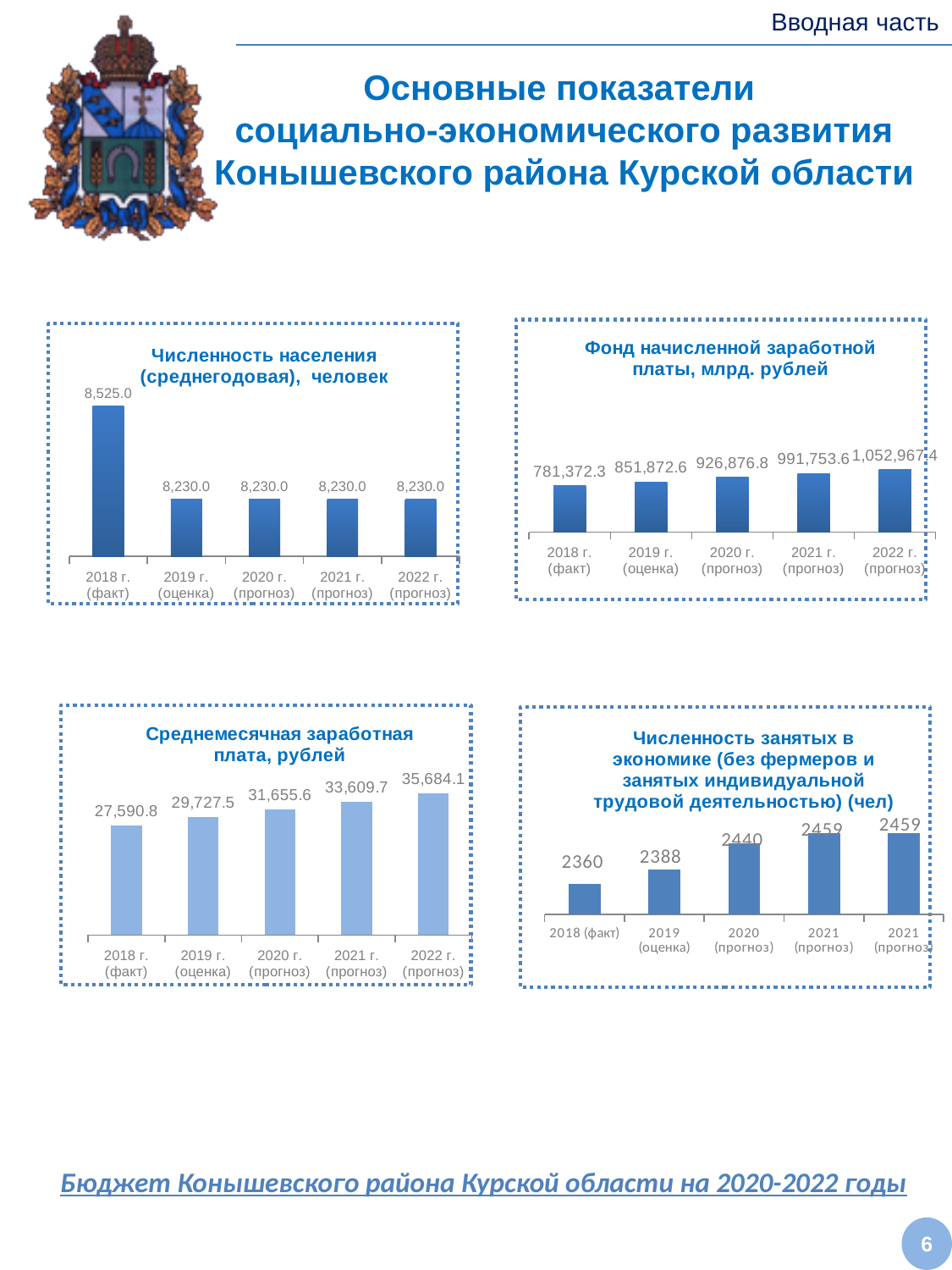
In the chart 'Численность населения (среднегодовая), человек', what is the difference between the 2018 г. (факт) value and the 2019 г. (оценка) value? 295.0 In the chart 'Среднемесячная заработная плата, рублей', which year has the lowest value? 2018 г. (факт) In the chart 'Численность населения (среднегодовая), человек', what is the value for 2020 г. (прогноз)? 8,230.0 In the chart 'Фонд начисленной заработной платы, млрд. рублей', what is the value for 2019 г. (оценка)? 851,872.6 In the chart 'Фонд начисленной заработной платы, млрд. рублей', which is larger: the value for 2020 г. (прогноз) or 2021 г. (прогноз)? 2021 г. (прогноз) In the chart 'Численность населения (среднегодовая), человек', which year has the highest value? 2018 г. (факт) In the chart 'Численность населения (среднегодовая), человек', what is the value for 2018 г. (факт)? 8,525.0 In the chart 'Численность занятых в экономике', what is the value for 2018 (факт)? 2360 What type of chart is used in the bottom-right chart 'Численность занятых в экономике'? bar chart In the chart 'Среднемесячная заработная плата, рублей', what is the value for 2022 г. (прогноз)? 35,684.1 In the chart 'Среднемесячная заработная плата, рублей', what is the difference between the 2022 г. (прогноз) value and the 2018 г. (факт) value? 8,093.3 In the chart 'Фонд начисленной заработной платы, млрд. рублей', do the values rise or fall from 2018 to 2022? rise